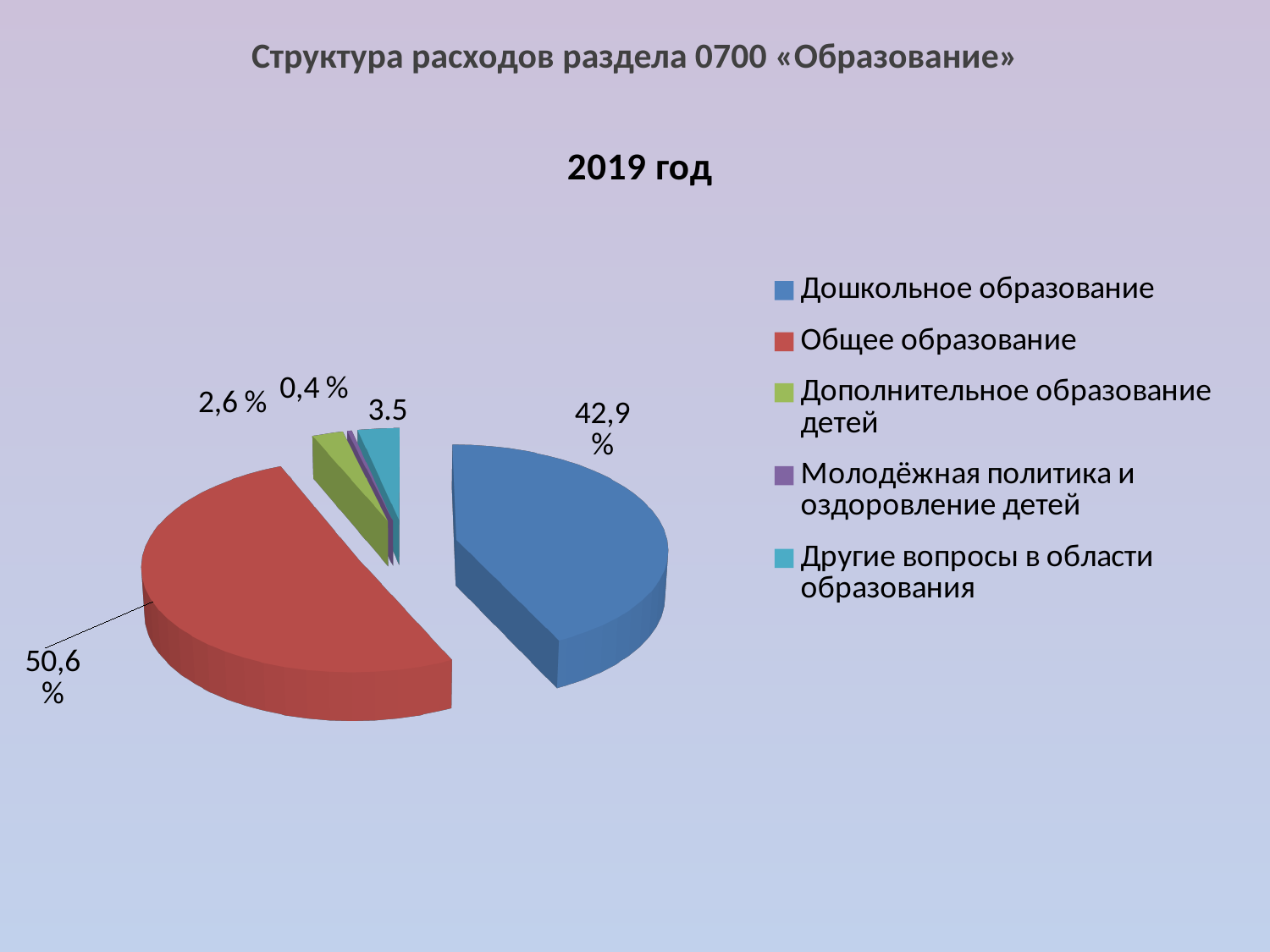
What is the title shown above the pie chart? 2019 год Which is larger: the value for Дошкольное образование or the value for Общее образование? Общее образование What is the value shown for Дошкольное образование? 42,9 % What is the difference between the values for Общее образование and Дошкольное образование? 7,7 % How many categories does the legend list? 5 Which category has the smallest share of the pie? Молодёжная политика и оздоровление детей What is the value shown for Молодёжная политика и оздоровление детей? 0,4 % What is the value shown for Общее образование? 50,6 % What type of chart is shown on the slide? pie chart What is the value shown for Другие вопросы в области образования? 3.5 Which category has the largest share of the pie? Общее образование What is the value shown for Дополнительное образование детей? 2,6 %